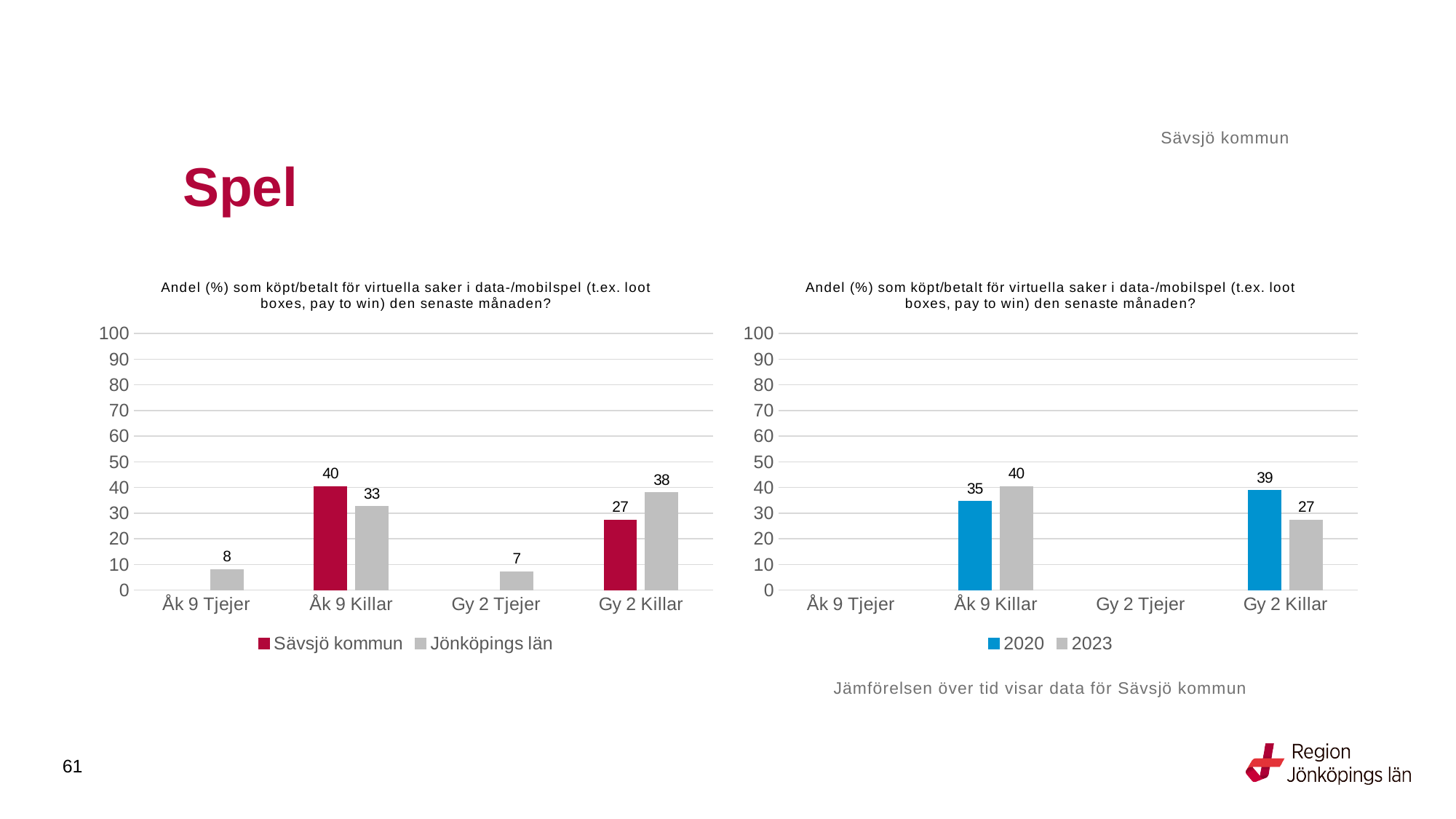
What kind of chart is the right chart? Bar chart In the left chart, what is the value for Jönköpings län for Åk 9 Tjejer? 8 In the right chart, which is larger for Åk 9 Killar: 2020 or 2023? 2023 In the right chart, what is the value for 2023 for Åk 9 Killar? 40 In the left chart, what is the value for Sävsjö kommun for Gy 2 Killar? 27 In the left chart, what is the difference between Sävsjö kommun and Jönköpings län for Gy 2 Killar? 11 In the left chart, which is larger for Åk 9 Killar: Sävsjö kommun or Jönköpings län? Sävsjö kommun In the left chart, what is the value for Jönköpings län for Åk 9 Killar? 33 In the left chart, which category has the highest value for Jönköpings län? Gy 2 Killar In the right chart, what is the difference between 2020 and 2023 for Gy 2 Killar? 12 In the left chart, how many series does the legend list? 2 In the right chart, what is the value for 2020 for Gy 2 Killar? 39